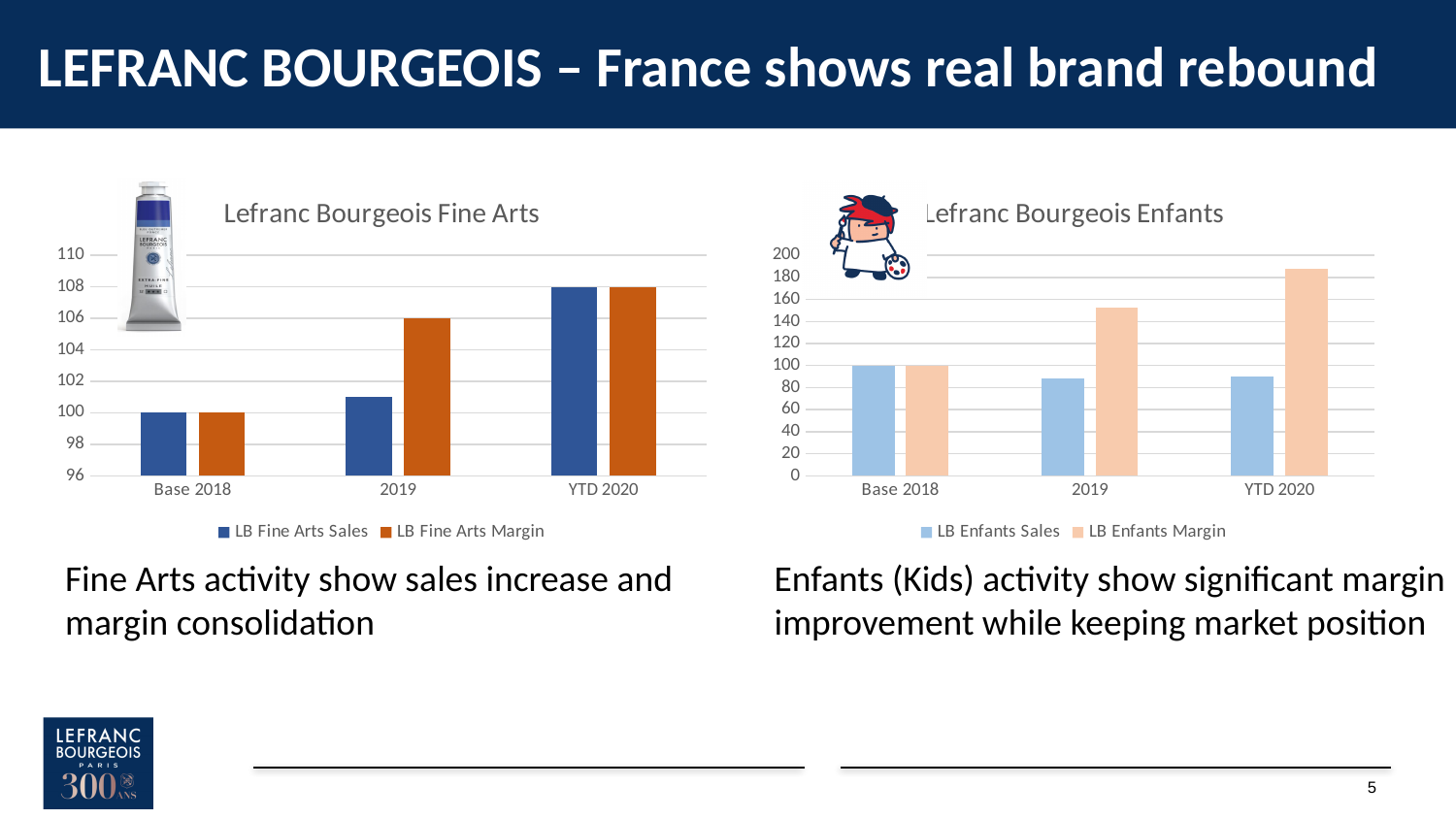
In the Lefranc Bourgeois Fine Arts chart, what is the value of LB Fine Arts Sales for YTD 2020? 108 What kind of chart is the Lefranc Bourgeois Fine Arts chart? bar chart In the Lefranc Bourgeois Fine Arts chart, what is the value of LB Fine Arts Margin for 2019? 106 In the Lefranc Bourgeois Fine Arts chart, is the value of LB Fine Arts Sales for 2019 greater or less than 104? less In the Lefranc Bourgeois Fine Arts chart, what is the value of LB Fine Arts Sales for Base 2018? 100 In the Lefranc Bourgeois Fine Arts chart, how many series does the legend list? 2 In the Lefranc Bourgeois Fine Arts chart, what is the difference between LB Fine Arts Margin for YTD 2020 and for Base 2018? 8 In the Lefranc Bourgeois Enfants chart, which is larger for YTD 2020: LB Enfants Sales or LB Enfants Margin? LB Enfants Margin In the Lefranc Bourgeois Enfants chart, which category has the highest LB Enfants Margin value? YTD 2020 In the Lefranc Bourgeois Enfants chart, is the value of LB Enfants Margin for 2019 greater or less than 140? greater In the Lefranc Bourgeois Fine Arts chart, do the LB Fine Arts Sales values rise or fall from Base 2018 to YTD 2020? rise How many categories are shown on the x axis of the Lefranc Bourgeois Enfants chart? 3